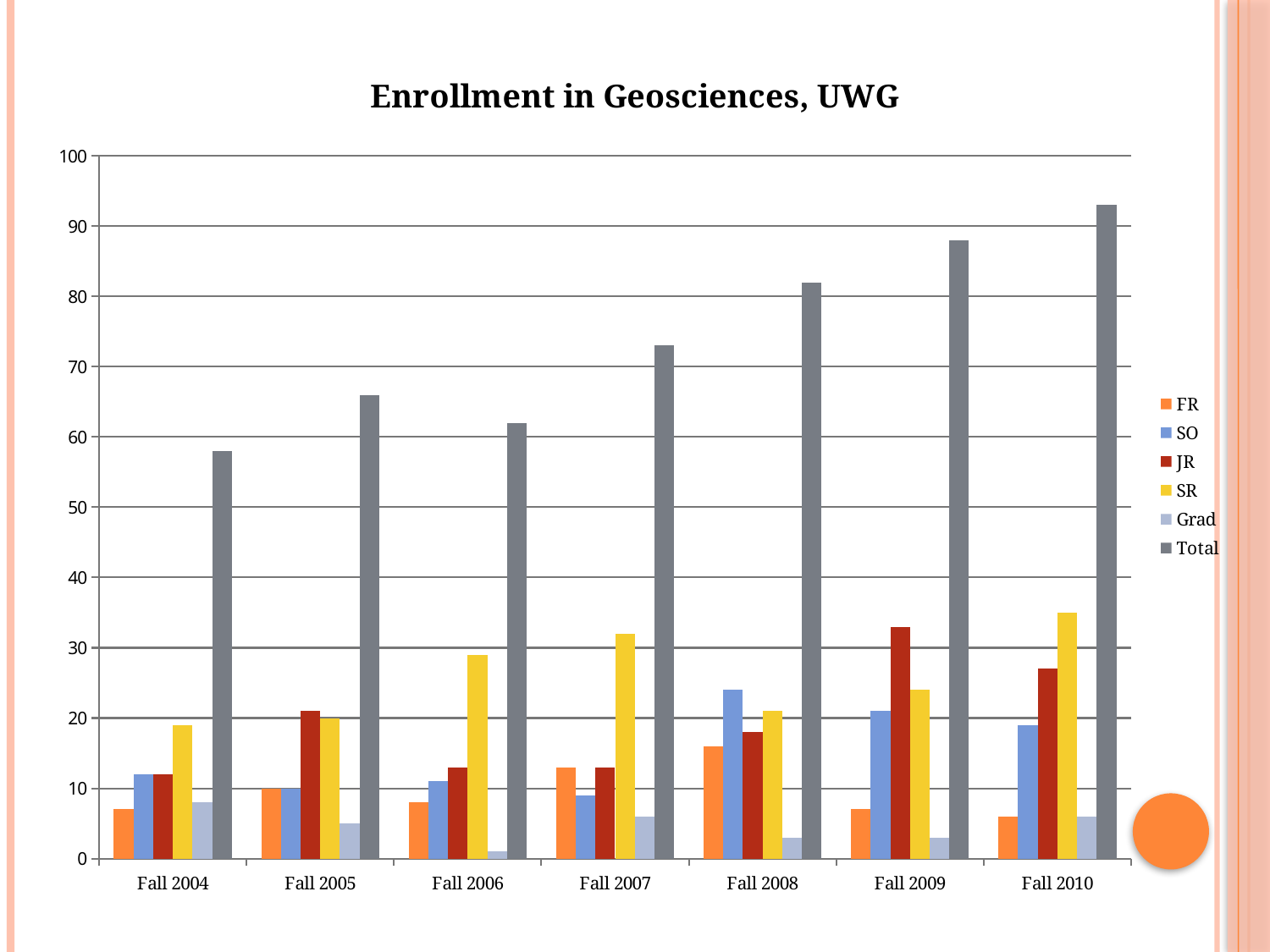
In Fall 2008, which is larger, FR or SO? SO What kind of chart is shown on the slide? bar chart Which semester has the lowest Total enrollment? Fall 2004 In Fall 2009, which is larger, JR or SR? JR What is the title of the chart? Enrollment in Geosciences, UWG Is the SR value for Fall 2007 greater or less than 30? greater How many series does the legend list? 6 Which semester has the highest Total enrollment? Fall 2010 Does the Total enrollment rise or fall from Fall 2004 to Fall 2010? rise Is the Total value for Fall 2004 greater or less than 60? less Is the Total value for Fall 2010 greater or less than 90? greater How many semesters are shown on the x axis? 7